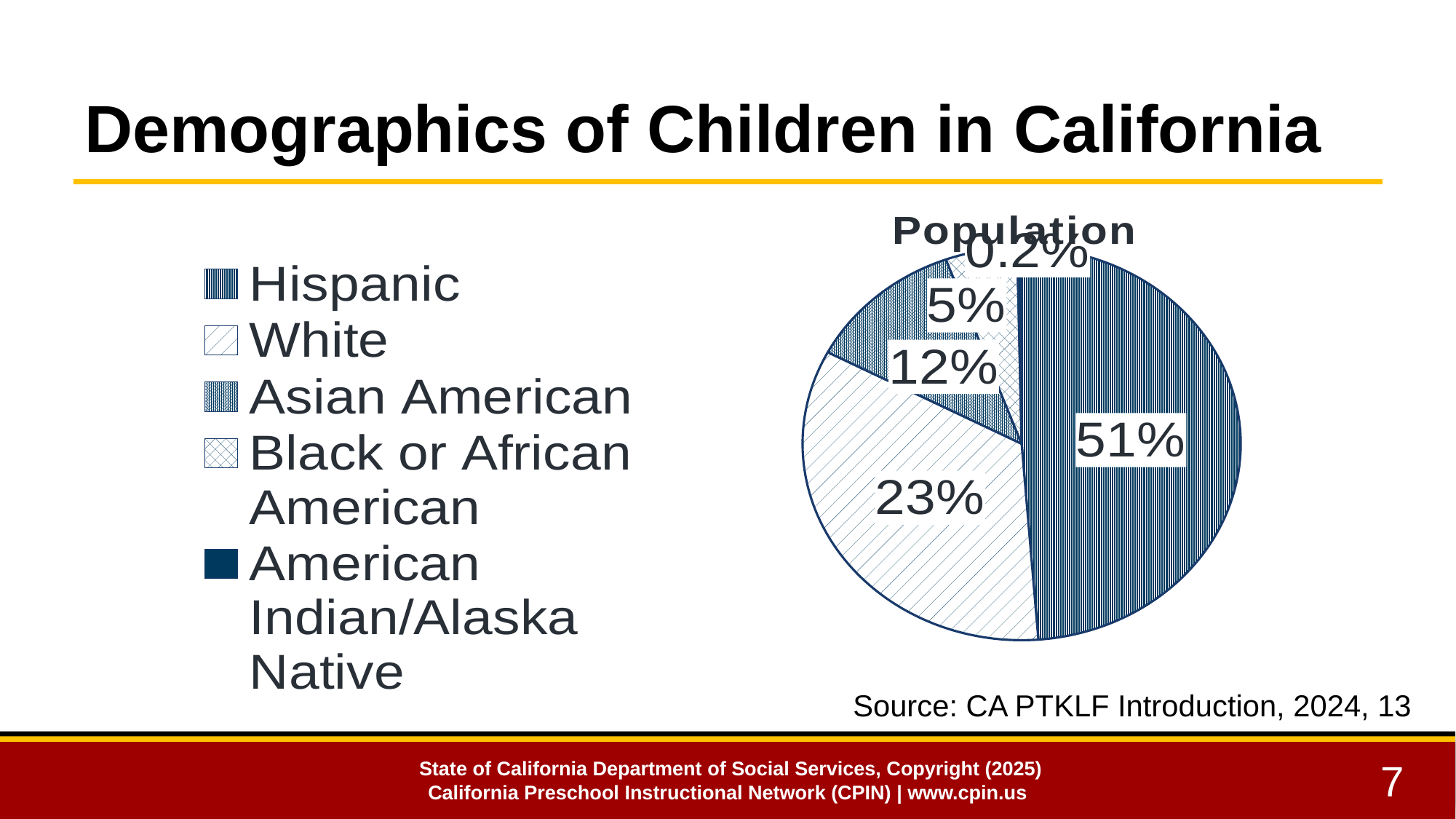
Which group has the largest share of the pie? Hispanic What percentage of the population is Black or African American? 5% What is the difference in percentage points between the Hispanic and White shares? 28 What percentage of the population is Hispanic? 51% What percentage of the population is American Indian/Alaska Native? 0.2% How many groups does the legend list? 5 Which group has the smallest share of the pie? American Indian/Alaska Native What is the title of the chart? Population What percentage of the population is Asian American? 12% What percentage of the population is White? 23% What type of chart is shown on the slide? pie chart Which is larger, the Asian American share or the Black or African American share? Asian American